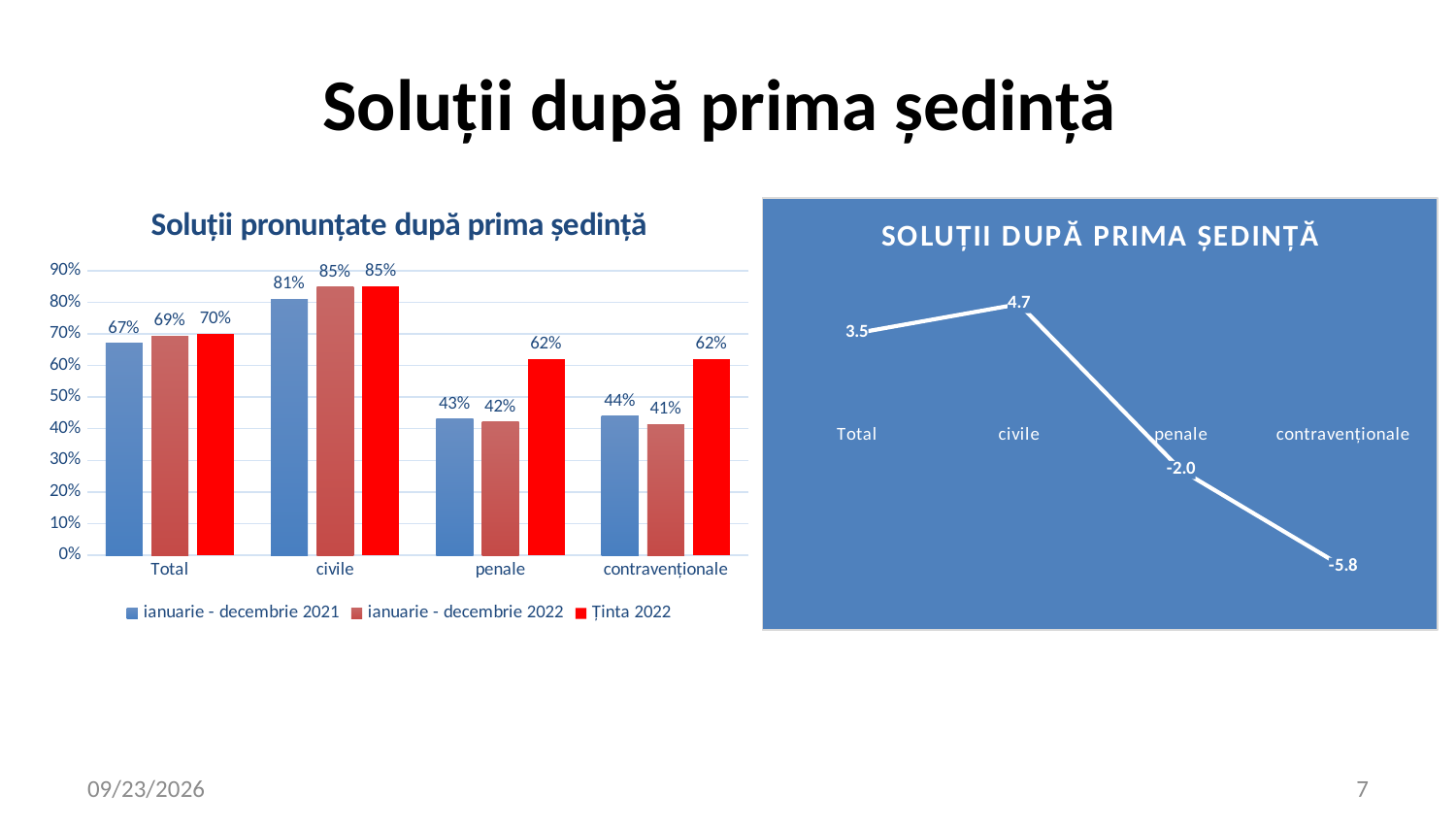
In the left chart 'Soluții pronunțate după prima ședință', what is the value for 'civile' in the series 'ianuarie - decembrie 2022'? 85% In the right chart 'SOLUȚII DUPĂ PRIMA ȘEDINȚĂ', what is the difference between the values for 'civile' and 'Total'? 1.2 In the right chart 'SOLUȚII DUPĂ PRIMA ȘEDINȚĂ', what is the value for 'penale'? -2.0 In the left chart 'Soluții pronunțate după prima ședință', what is the difference between the 'Ținta 2022' value and the 'ianuarie - decembrie 2022' value for 'contravenționale'? 21% In the left chart 'Soluții pronunțate după prima ședință', which is larger for 'Total': the 'ianuarie - decembrie 2021' value or the 'ianuarie - decembrie 2022' value? ianuarie - decembrie 2022 In the left chart 'Soluții pronunțate după prima ședință', which category has the highest value in the series 'ianuarie - decembrie 2021'? civile In the left chart 'Soluții pronunțate după prima ședință', which category has the lowest value in the series 'ianuarie - decembrie 2022'? contravenționale In the left chart 'Soluții pronunțate după prima ședință', what is the 'Ținta 2022' value for 'penale'? 62% In the right chart 'SOLUȚII DUPĂ PRIMA ȘEDINȚĂ', which category has the lowest value? contravenționale What kind of chart is the right chart 'SOLUȚII DUPĂ PRIMA ȘEDINȚĂ'? line chart How many series does the legend of the left chart 'Soluții pronunțate după prima ședință' list? 3 What kind of chart is the left chart 'Soluții pronunțate după prima ședință'? bar chart